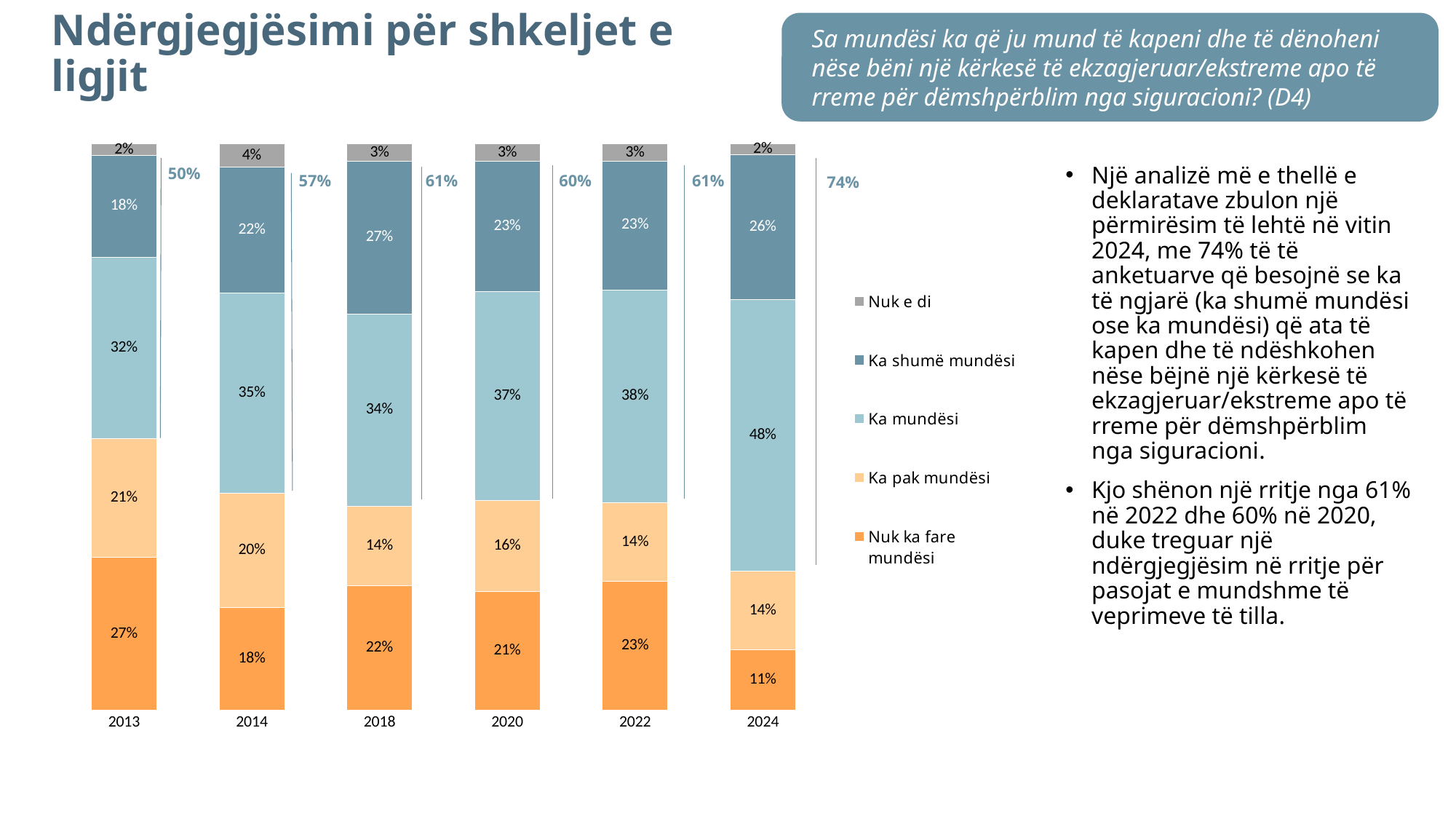
What is the value for 'Nuk ka fare mundësi' in 2013? 27% What is the combined share of 'Ka shumë mundësi' and 'Ka mundësi' shown next to the 2024 bar? 74% Which is larger, the 'Ka pak mundësi' value in 2013 or in 2014? 2013 How many years are shown on the x axis of the chart? 6 In which year is the 'Nuk ka fare mundësi' value lowest? 2024 What kind of chart is shown on the slide? stacked bar chart How many series does the legend list? 5 What is the difference between the 'Ka mundësi' values for 2024 and 2022? 10% What is the value for 'Ka shumë mundësi' in 2018? 27% Which legend entry is shown in orange? Nuk ka fare mundësi What is the value for 'Ka mundësi' in 2024? 48% In which year is the 'Ka mundësi' value highest? 2024